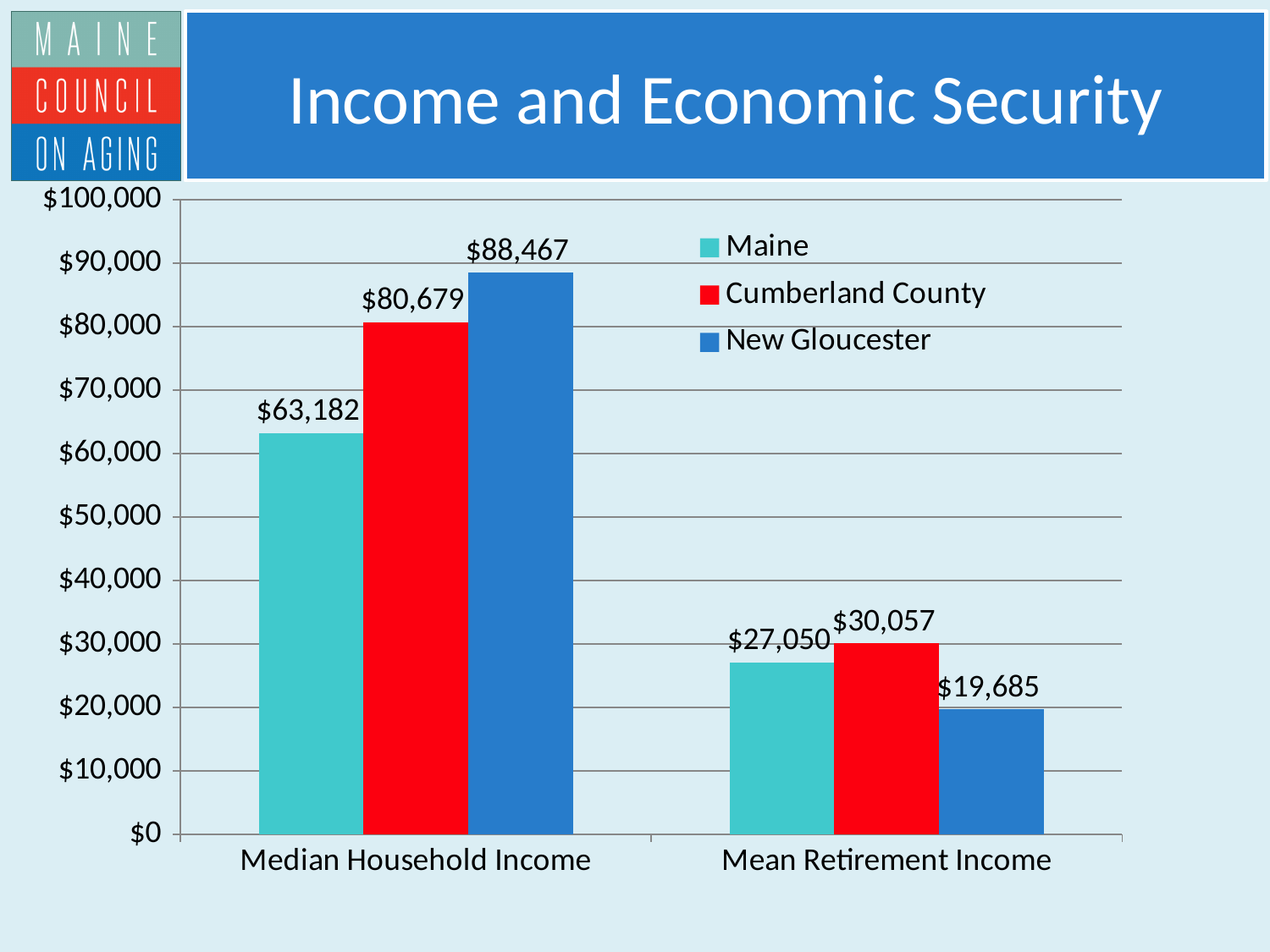
Which series has the highest Median Household Income? New Gloucester What is the difference between the Median Household Income for New Gloucester and for Maine? $25,285 Which series has the lowest Mean Retirement Income? New Gloucester How many categories are shown on the x axis? 2 What is the Mean Retirement Income for Maine? $27,050 How many series does the legend list? 3 What kind of chart is shown on the slide? Bar chart Is the Median Household Income for Maine greater or less than $60,000? greater What is the difference between the Mean Retirement Income for Cumberland County and for New Gloucester? $10,372 What is the Median Household Income for New Gloucester? $88,467 Which is larger: the Mean Retirement Income for Maine or for Cumberland County? Cumberland County What is the Median Household Income for Cumberland County? $80,679